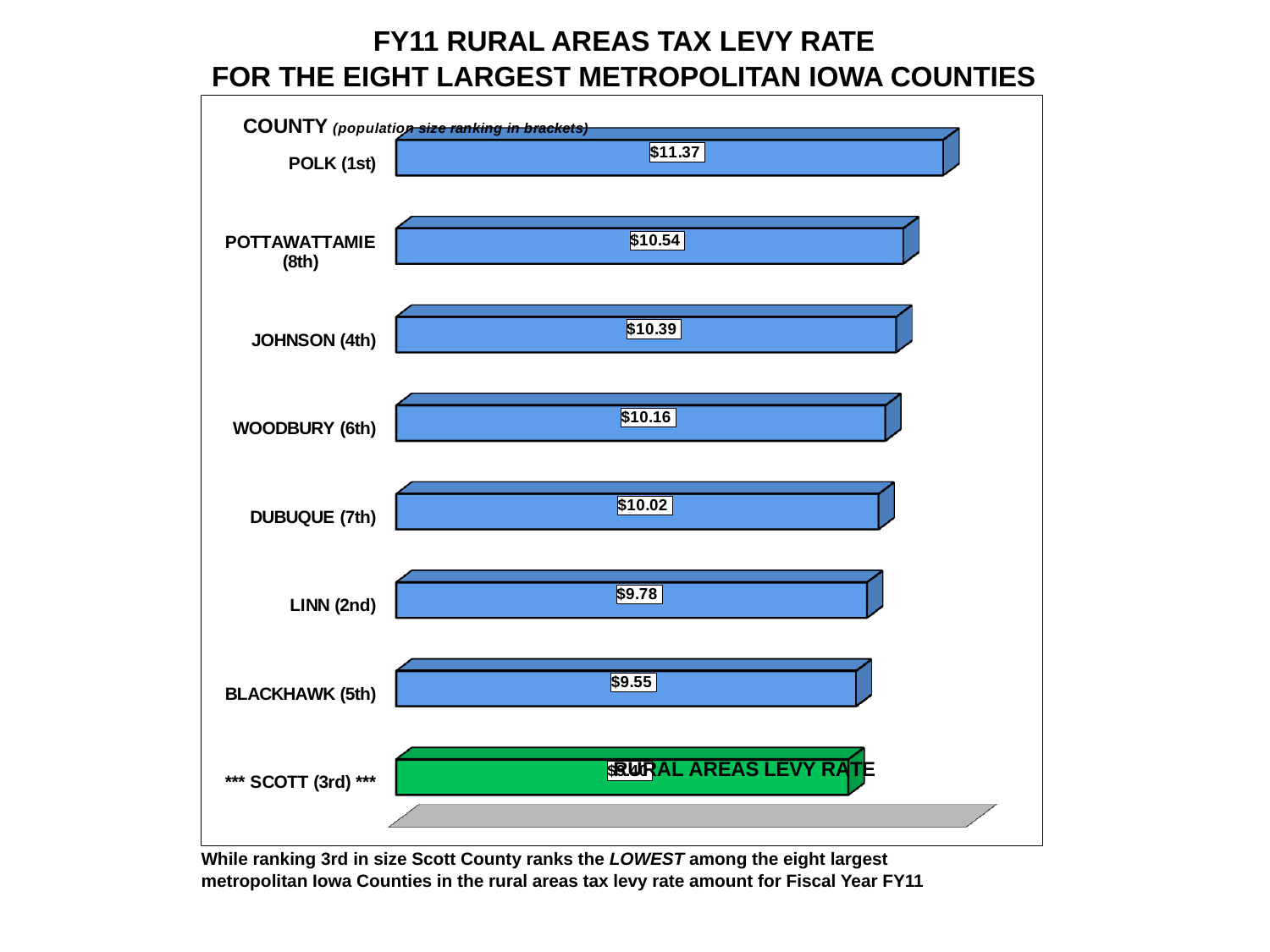
How many counties are shown on the chart? 8 Which county has the highest rural areas tax levy rate on the chart? Polk (1st) Which county's bar is coloured green instead of blue? Scott (3rd) Which has a higher rural areas tax levy rate, Johnson (4th) or Linn (2nd)? Johnson (4th) What is the FY11 rural areas tax levy rate for Polk (1st)? $11.37 What is the rural areas tax levy rate shown for Blackhawk (5th)? $9.55 What is the rural areas tax levy rate shown for Johnson (4th)? $10.39 Which county has the lowest rural areas tax levy rate on the chart? Scott (3rd) What kind of chart is shown on the slide? Bar chart What is the difference between the levy rates of Polk (1st) and Pottawattamie (8th)? $0.83 What is the rural areas tax levy rate shown for Linn (2nd)? $9.78 What is the difference between the levy rates of Woodbury (6th) and Dubuque (7th)? $0.14